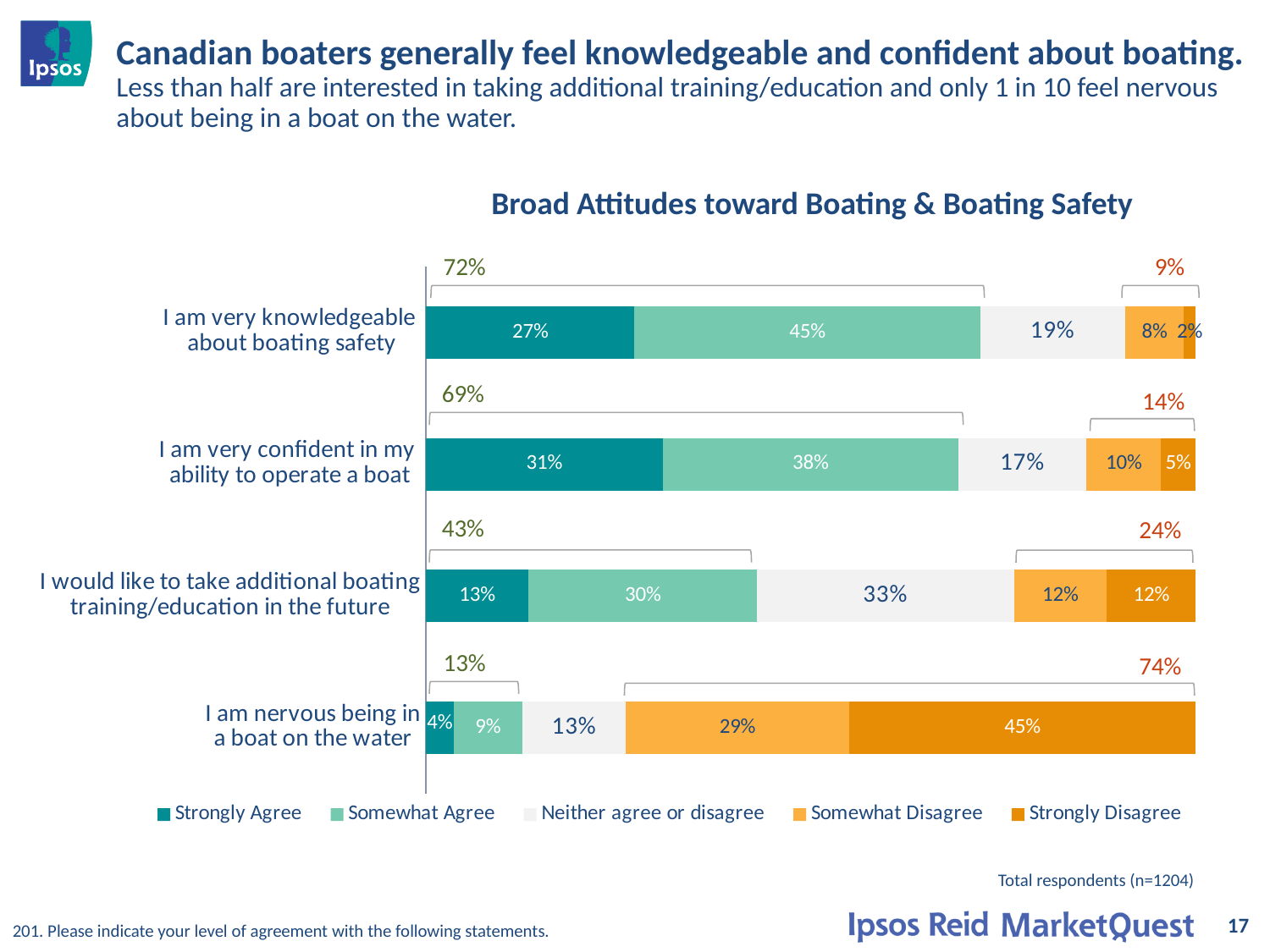
Which statement has the highest 'Strongly Agree' value? I am very confident in my ability to operate a boat Which is larger: the 'Somewhat Disagree' value for 'I am nervous being in a boat on the water' or the 'Somewhat Disagree' value for 'I would like to take additional boating training/education in the future'? I am nervous being in a boat on the water What percentage of respondents strongly agree that they are very confident in their ability to operate a boat? 31% How many series does the legend list? 5 How many statements (categories) are plotted in the chart? 4 Which statement has the lowest 'Strongly Agree' value? I am nervous being in a boat on the water What is the difference between the 'Somewhat Agree' values for 'I am very knowledgeable about boating safety' and 'I am very confident in my ability to operate a boat'? 7% What is the title of the chart? Broad Attitudes toward Boating & Boating Safety What kind of chart is shown on the slide? Stacked bar chart What percentage of respondents strongly disagree with the statement 'I am nervous being in a boat on the water'? 45% What is the 'Neither agree or disagree' value for 'I would like to take additional boating training/education in the future'? 33% What percentage of respondents somewhat agree that they are very knowledgeable about boating safety? 45%